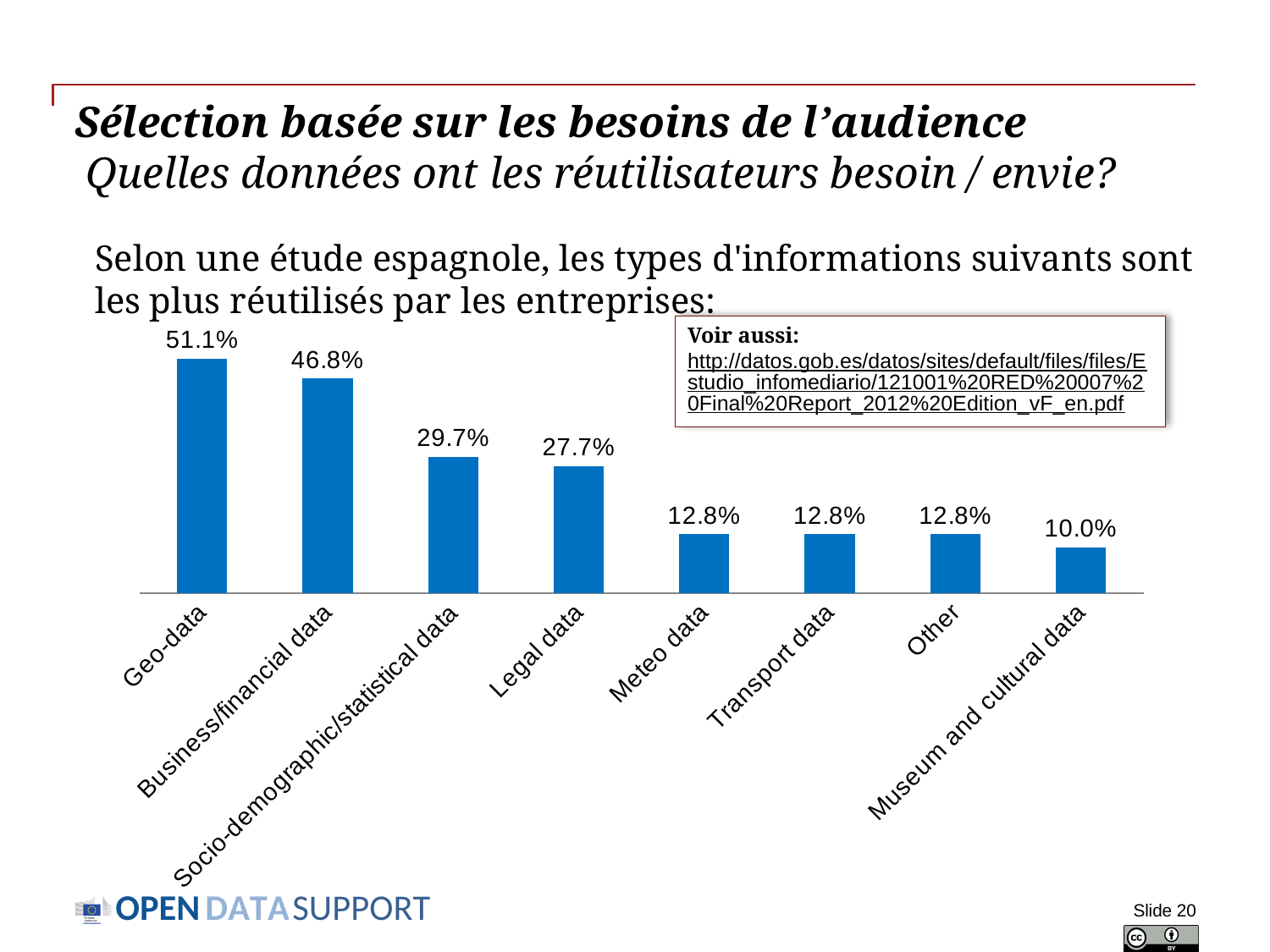
What is the value for Geo-data? 51.1% What is the difference between the values for Socio-demographic/statistical data and Legal data? 2.0% What kind of chart is shown on the slide? Bar chart What is the value for Museum and cultural data? 10.0% What is the value for Socio-demographic/statistical data? 29.7% Which category has the lowest value? Museum and cultural data Which is larger, the value for Business/financial data or the value for Legal data? Business/financial data What is the value for Legal data? 27.7% Which category has the highest value? Geo-data How many categories are shown in the chart? 8 Do the values rise or fall from left to right along the x axis? Fall What is the difference between the values for Geo-data and Business/financial data? 4.3%